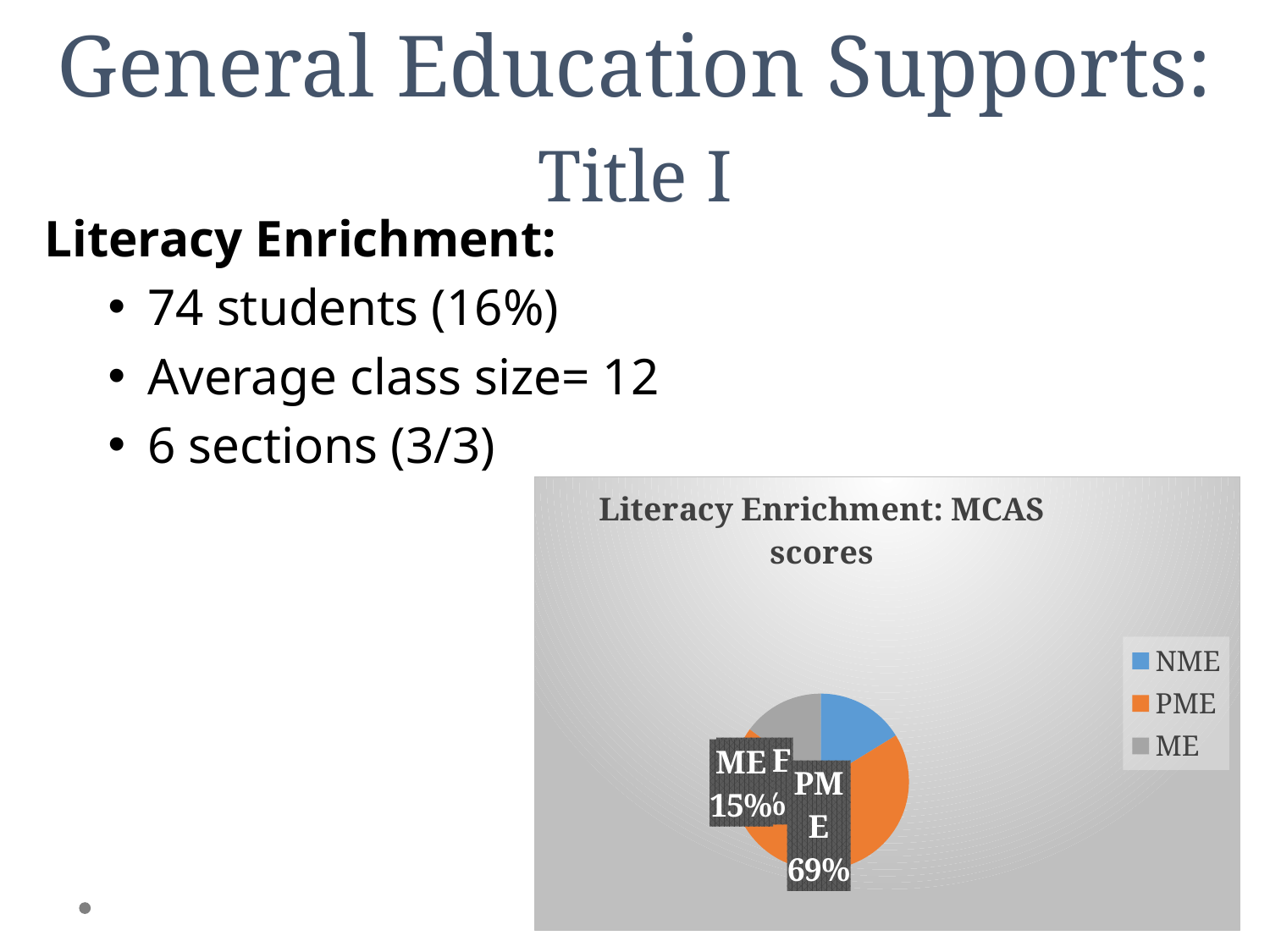
Which category has the largest slice of the pie? PME How many entries does the chart legend list? 3 How many percentage points larger is the PME share than the ME share? 54 What is the title of the chart on the slide? Literacy Enrichment: MCAS scores What kind of chart is shown on the slide? pie chart Which is larger, the PME slice or the ME slice? PME What share of the pie does PME represent? 69% What colour is the PME slice in the pie chart? orange What share of the pie does ME represent? 15% How many categories does the pie chart show? 3